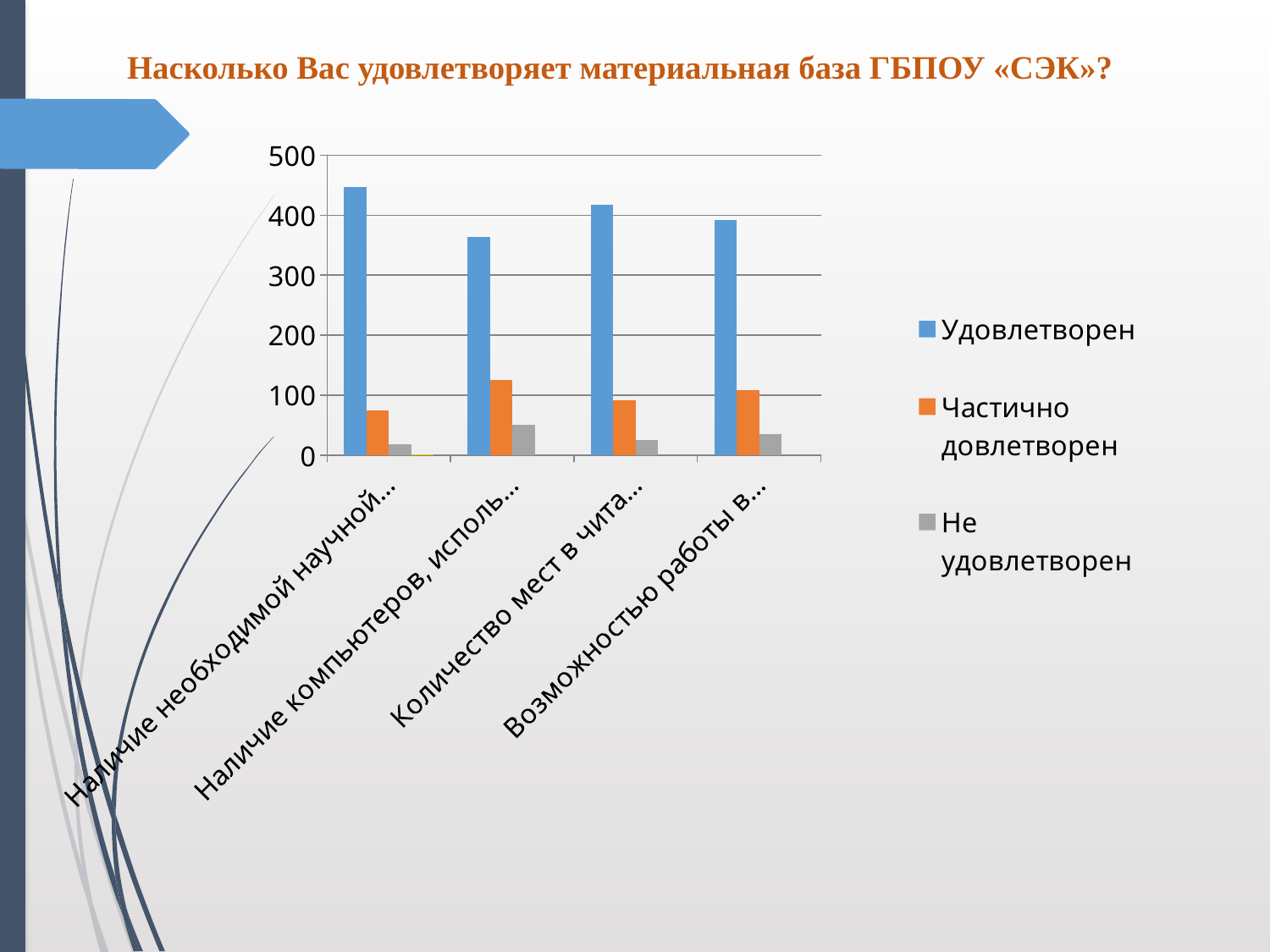
For which category is the 'Удовлетворен' series lowest? Наличие компьютеров, исполь... What kind of chart is shown on the slide? bar chart How many categories are plotted along the x axis? 4 In the fourth category ('Возможностью работы в...'), which is larger: the 'Удовлетворен' value or the 'Частично удовлетворен' value? Удовлетворен Is the value of the 'Удовлетворен' series for the first category ('Наличие необходимой научной...') greater or less than 400? greater Is the value of the 'Не удовлетворен' series for the third category ('Количество мест в чита...') greater or less than 100? less How many series does the legend list? 3 What is the title of the slide above the chart? Насколько Вас удовлетворяет материальная база ГБПОУ «СЭК»? For which category is the 'Удовлетворен' series highest? Наличие необходимой научной... Which series is shown in blue according to the legend? Удовлетворен Is the value of the 'Частично удовлетворен' series for the second category ('Наличие компьютеров, исполь...') greater or less than 100? greater